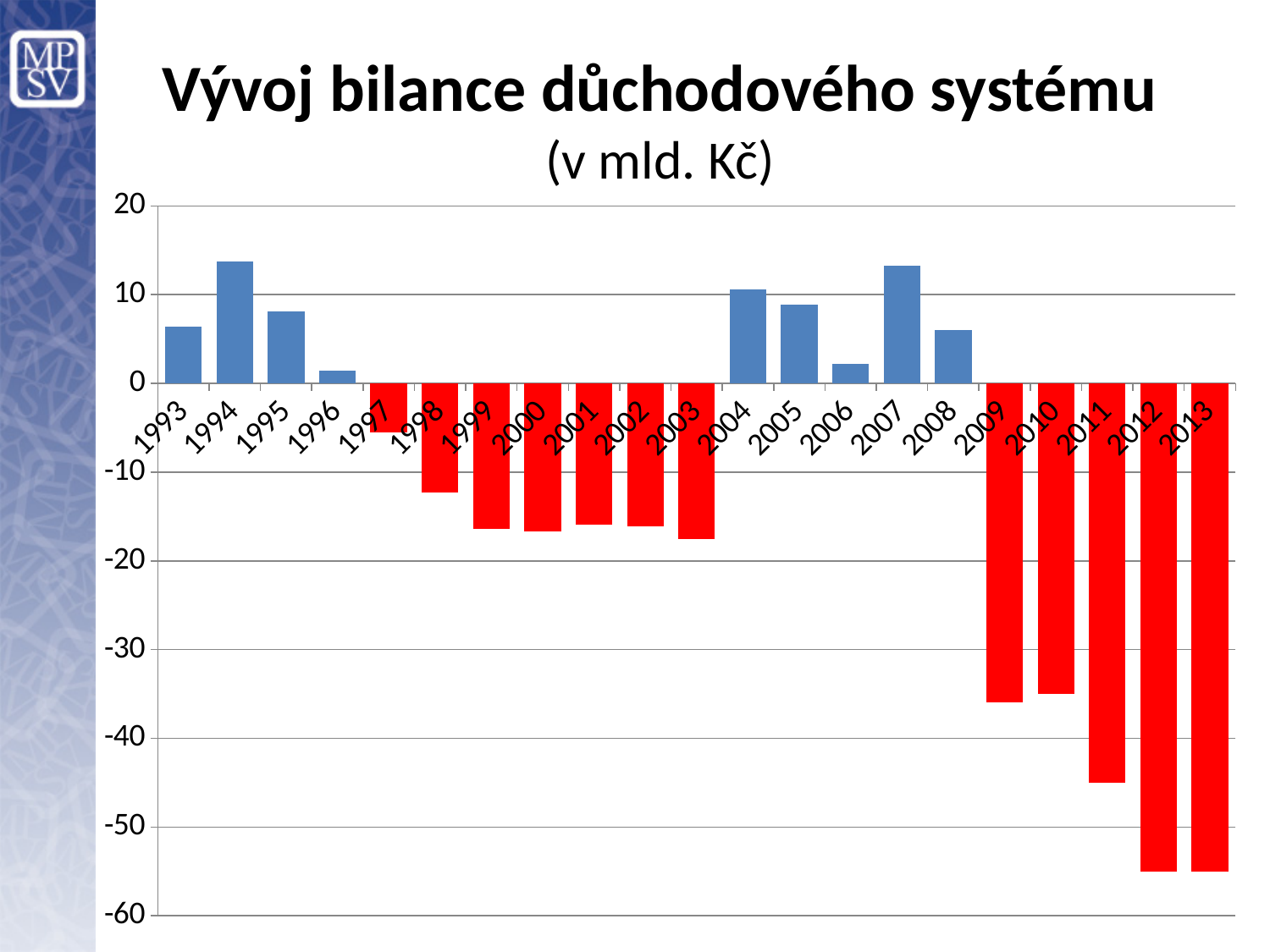
What kind of chart is shown on the slide? bar chart Which year has the larger value, 2004 or 2006? 2004 Is the value for 2009 greater or less than -30? less Is the value for 1996 greater or less than 10? less Which year has the larger value, 1994 or 1995? 1994 Is the value for 2011 greater or less than -40? less How many years are plotted on the x axis of the chart? 21 Do the values rise or fall from 2008 to 2012? fall What colour are the bars with negative values? red